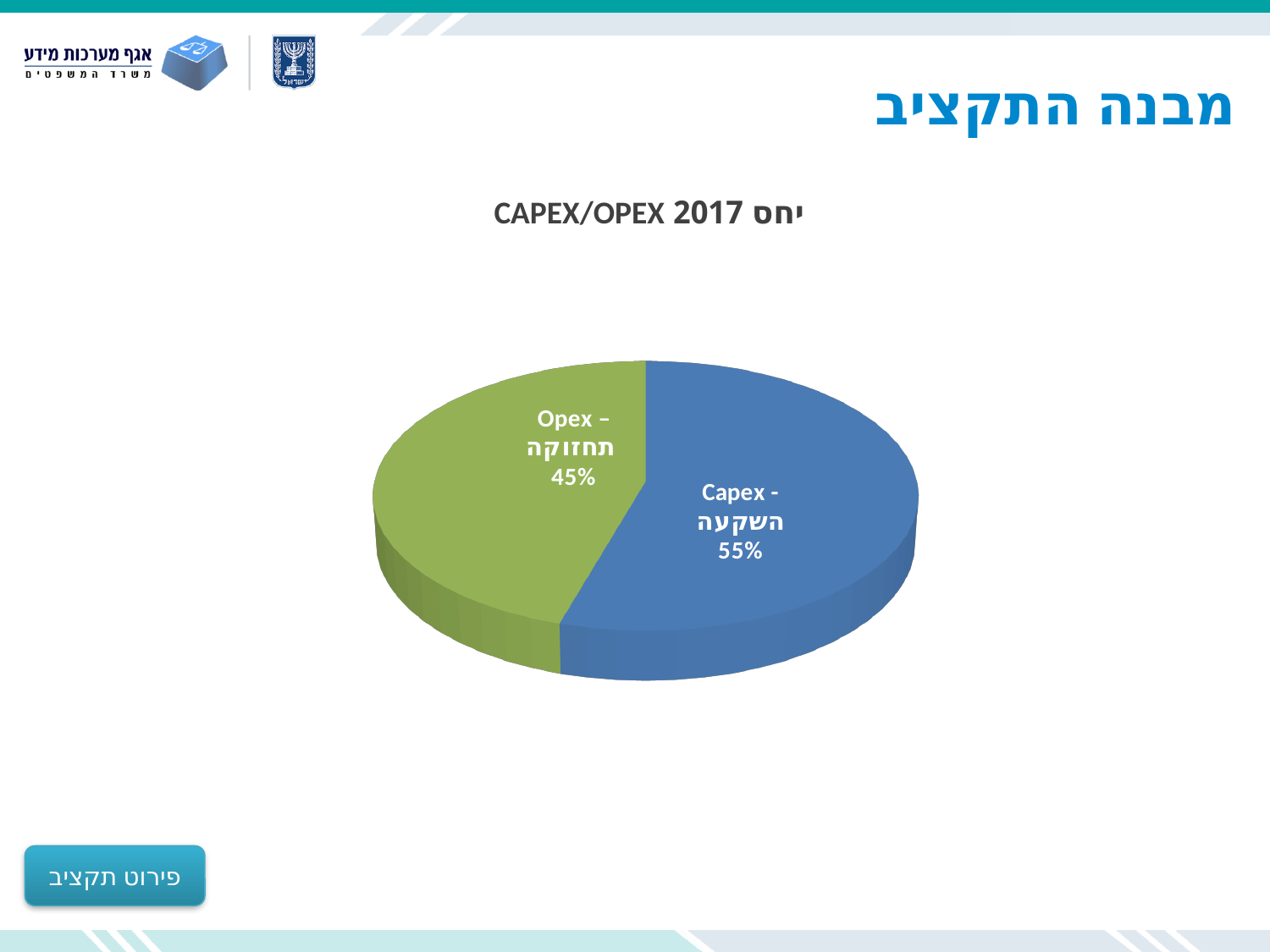
What is the difference in percentage points between the Capex and Opex slices? 10 percentage points Which slice is the smallest in the pie chart? Opex – תחזוקה Is the share for Opex – תחזוקה greater or less than 50%? less What kind of chart is shown on the slide? Pie chart How many slices does the pie chart have? 2 Which slice is the largest in the pie chart? Capex - השקעה Which is larger, the Capex - השקעה slice or the Opex – תחזוקה slice? Capex - השקעה What colour is the Capex - השקעה slice? Blue What is the title of the chart? יחס CAPEX/OPEX 2017 What share of the pie does the Capex - השקעה slice represent? 55% What share of the pie does the Opex – תחזוקה slice represent? 45%